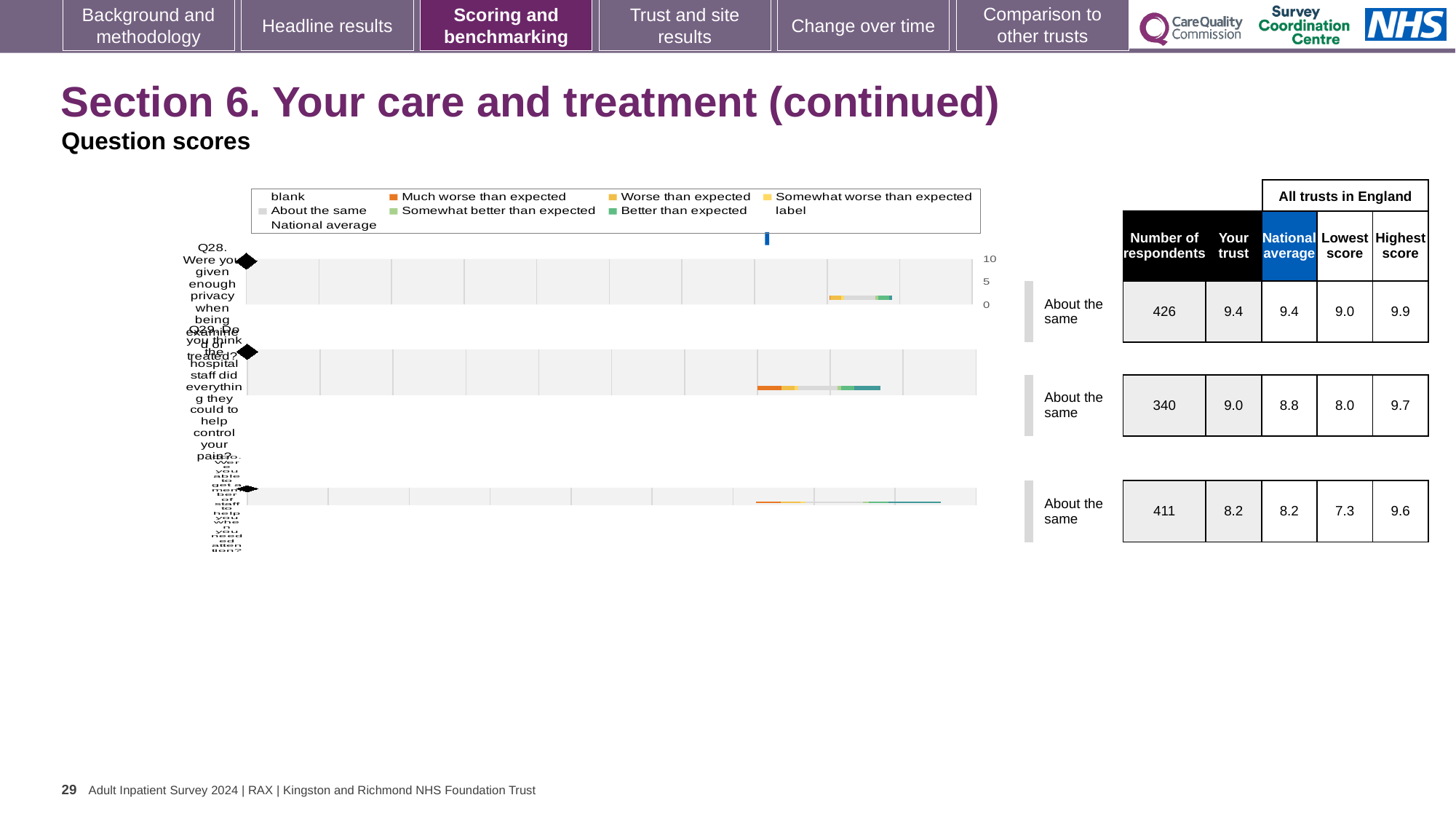
What colour does the legend use for 'Much worse than expected'? orange In the table beside the charts, what is the lowest score for Q30? 7.3 What is the highest tick value shown on the chart's score axis? 10 What is the difference between the highest score and the lowest score for Q30? 2.3 How many questions (charts) are plotted on this slide? 3 In the table beside the charts, how many respondents are listed for Q29? 340 In the table beside the charts, what is the national average for Q30? 8.2 How many entries does the chart legend list? 9 In the table beside the charts, what is the 'Your trust' score for Q28? 9.4 Which question has the fewest respondents: Q28, Q29 or Q30? Q29 What kind of chart is used to show the question scores on this slide? bar chart Which question has the highest 'Your trust' score: Q28, Q29 or Q30? Q28